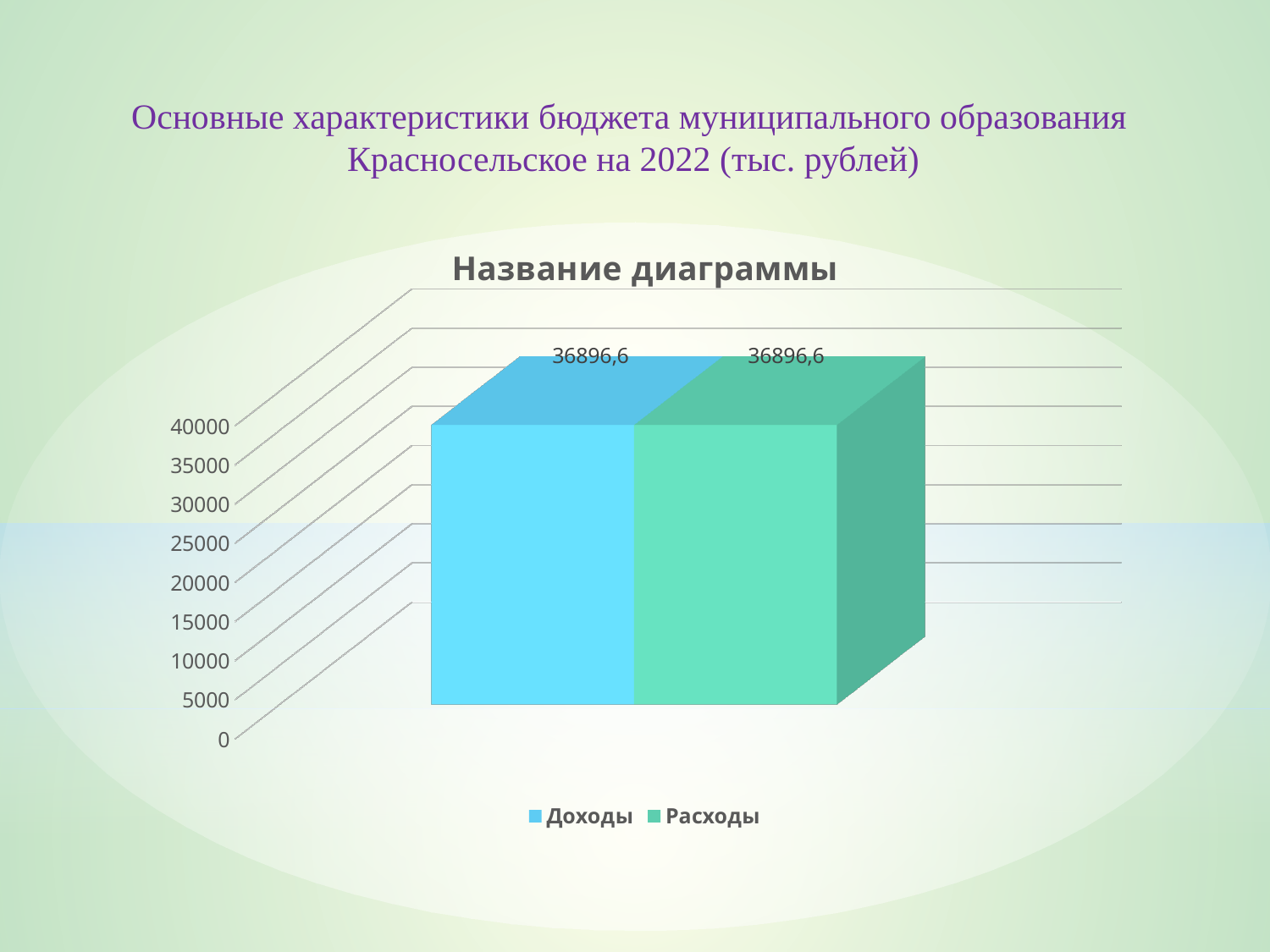
How many series does the legend list? 2 Is the value for Доходы greater or less than 35000? greater What is the difference between the values for Доходы and Расходы? 0 What is the value for Доходы? 36896,6 What is the highest value labelled on the vertical axis? 40000 What kind of chart is shown on the slide? bar chart Which series is shown in green in the legend? Расходы What is the value for Расходы? 36896,6 Is the value for Расходы greater or less than 40000? less What is the title of the chart? Название диаграммы How many bars are plotted on the chart? 2